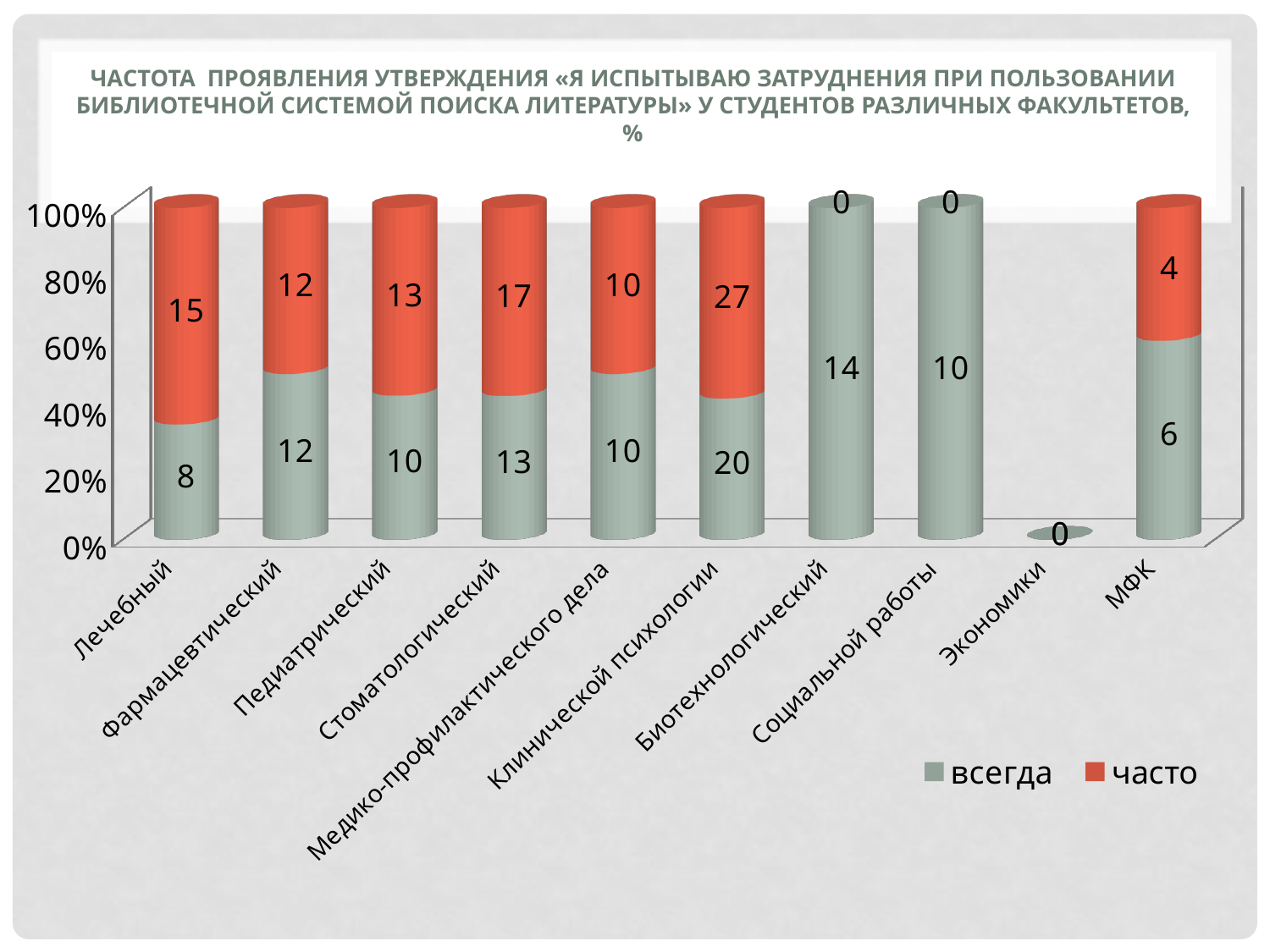
What is the difference between the «часто» and «всегда» values for Стоматологический? 4 What kind of chart is shown on the slide? Stacked bar chart Which faculty has the highest «всегда» value? Клинической психологии What is the sum of the «всегда» and «часто» labels for Педиатрический? 23 How many series does the legend list? 2 What is the value of «часто» for МФК? 4 Which is larger for Лечебный: the «всегда» value or the «часто» value? часто What is the value of «всегда» for Биотехнологический? 14 What is the value of «часто» for Клинической психологии? 27 How many faculties are shown on the x axis? 10 What is the value of «всегда» for Лечебный? 8 Which faculty has the highest «часто» value? Клинической психологии